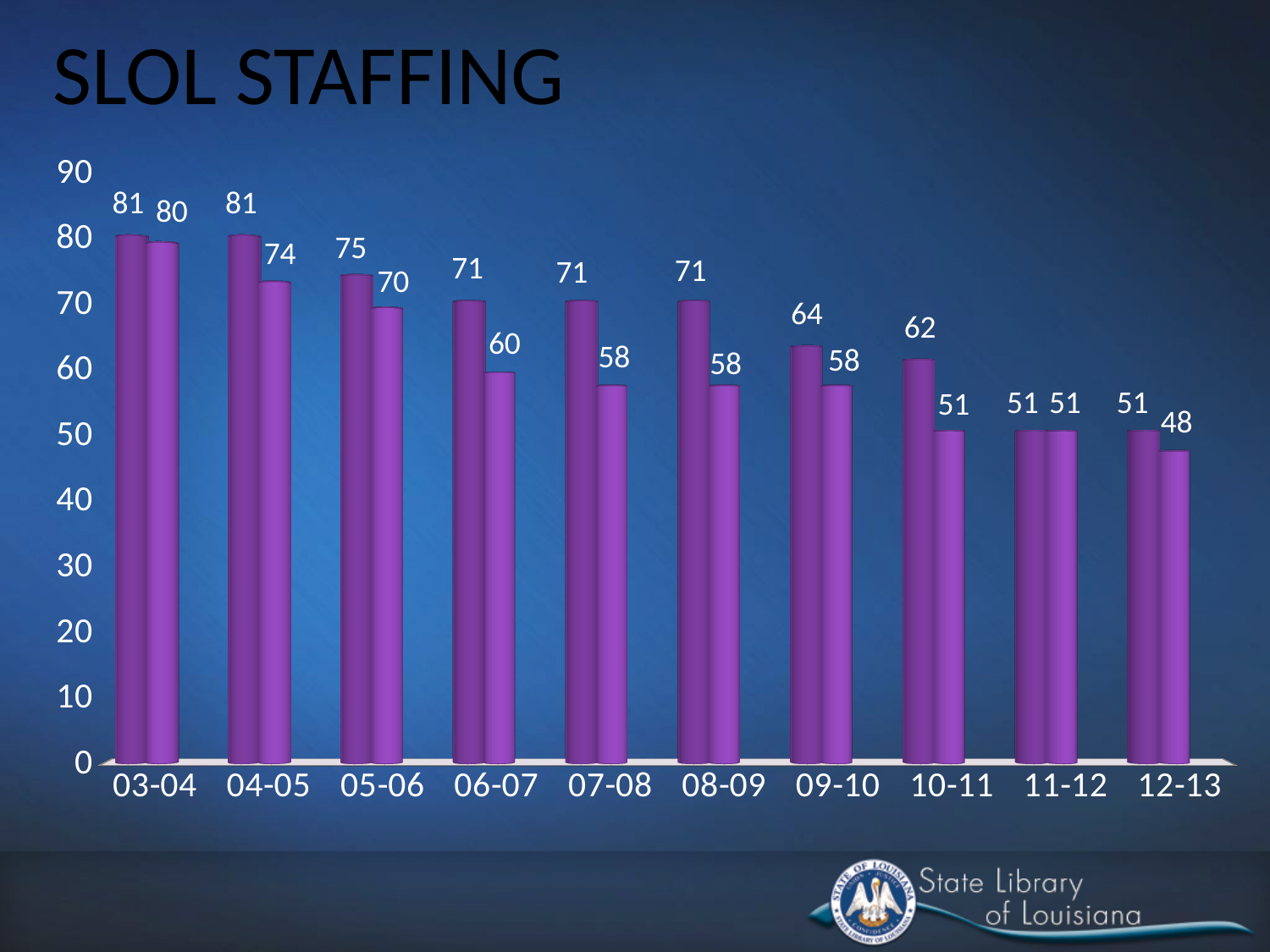
Do the left-bar values generally rise or fall from 03-04 to 12-13? fall What is the value of the right bar for 12-13? 48 Which year has the lowest right-bar value? 12-13 What is the difference between the left and right bars for 10-11? 11 What is the value of the right bar for 06-07? 60 What is the difference between the left bar for 03-04 and the left bar for 12-13? 30 Which is larger: the left bar for 05-06 or the right bar for 04-05? left bar for 05-06 What type of chart is shown? bar chart What is the title of the chart? SLOL STAFFING How many years are shown on the x axis? 10 What is the value of the left bar for 09-10? 64 What is the value of the left bar for 03-04? 81